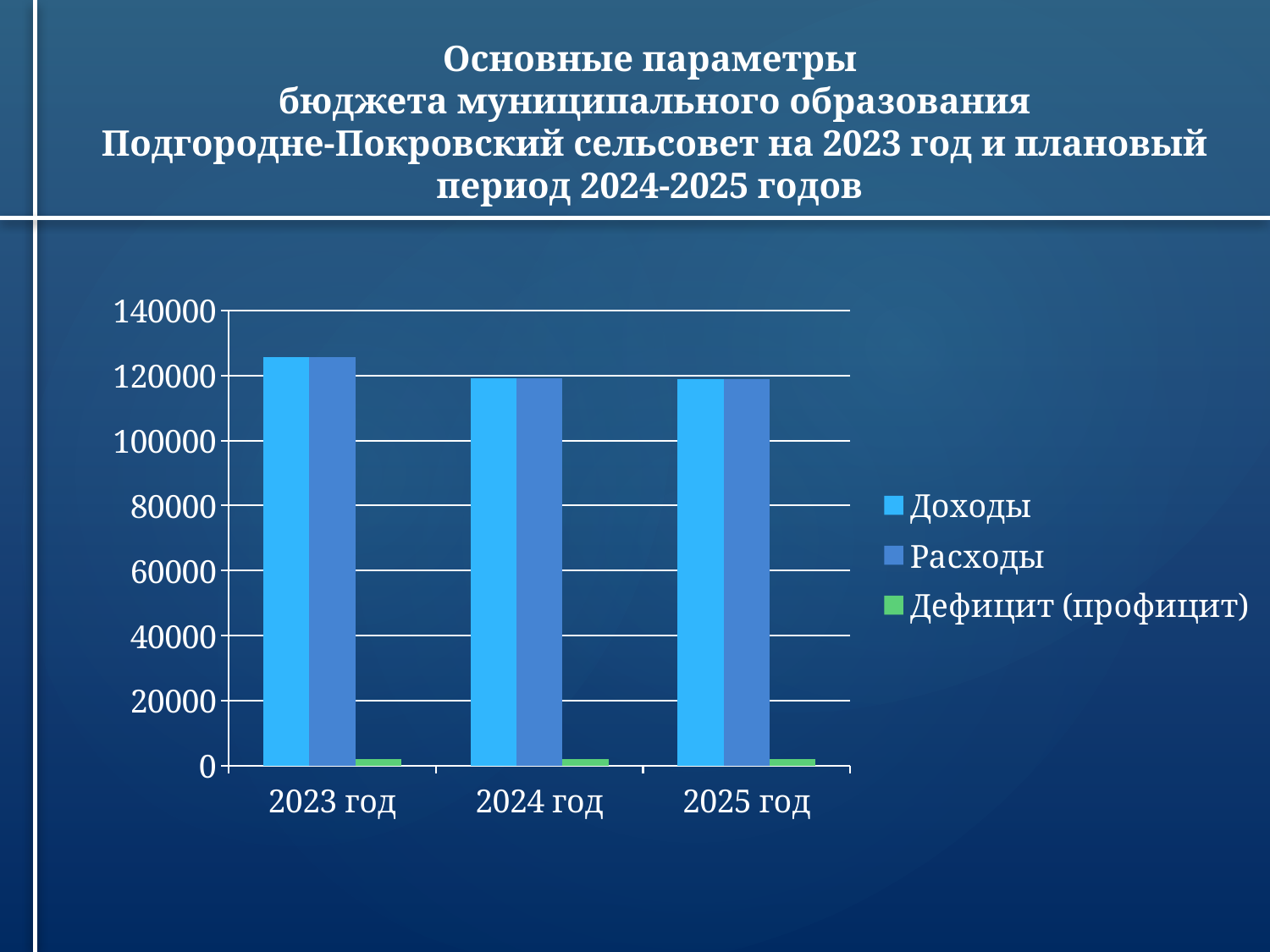
Is the value for Расходы in 2025 год greater or less than 100000? greater Is the value for Доходы in 2023 год greater or less than 120000? greater Is the value for Дефицит (профицит) in 2023 год greater or less than 20000? less Which is larger: Доходы in 2023 год or Доходы in 2024 год? Доходы in 2023 год How many year categories are shown on the x axis? 3 Does the value for Расходы rise or fall from 2023 год to 2024 год? fall Which series has the lowest value in 2024 год? Дефицит (профицит) How many series does the legend list? 3 In which year is the value for Доходы highest? 2023 год What colour represents Дефицит (профицит) in the legend? green What kind of chart is shown on the slide? bar chart